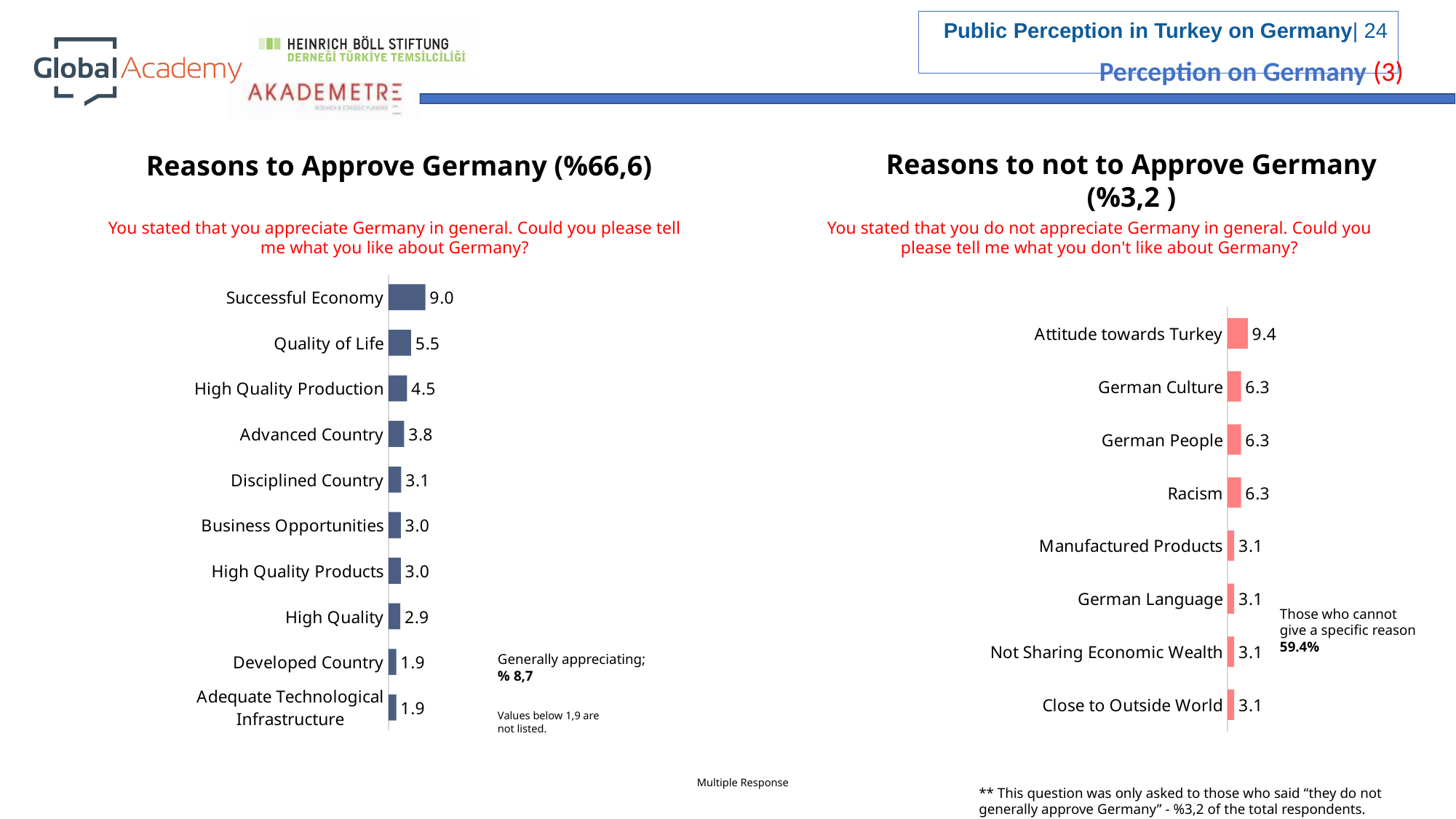
In the 'Reasons to not to Approve Germany' chart, what is the value for Attitude towards Turkey? 9.4 In the 'Reasons to Approve Germany' chart, what is the value for Successful Economy? 9.0 In the 'Reasons to not to Approve Germany' chart, which category has the highest value? Attitude towards Turkey In the 'Reasons to Approve Germany' chart, which is larger: Advanced Country or Disciplined Country? Advanced Country In the 'Reasons to Approve Germany' chart, which category has the highest value? Successful Economy What type of chart is the 'Reasons to not to Approve Germany' chart? Bar chart In the 'Reasons to Approve Germany' chart, what is the value for High Quality Production? 4.5 In the 'Reasons to not to Approve Germany' chart, how many categories are plotted? 8 In the 'Reasons to not to Approve Germany' chart, what is the difference between Attitude towards Turkey and German Culture? 3.1 In the 'Reasons to not to Approve Germany' chart, what is the value for Racism? 6.3 In the 'Reasons to Approve Germany' chart, how many categories are plotted? 10 In the 'Reasons to Approve Germany' chart, what is the difference between Successful Economy and Quality of Life? 3.5